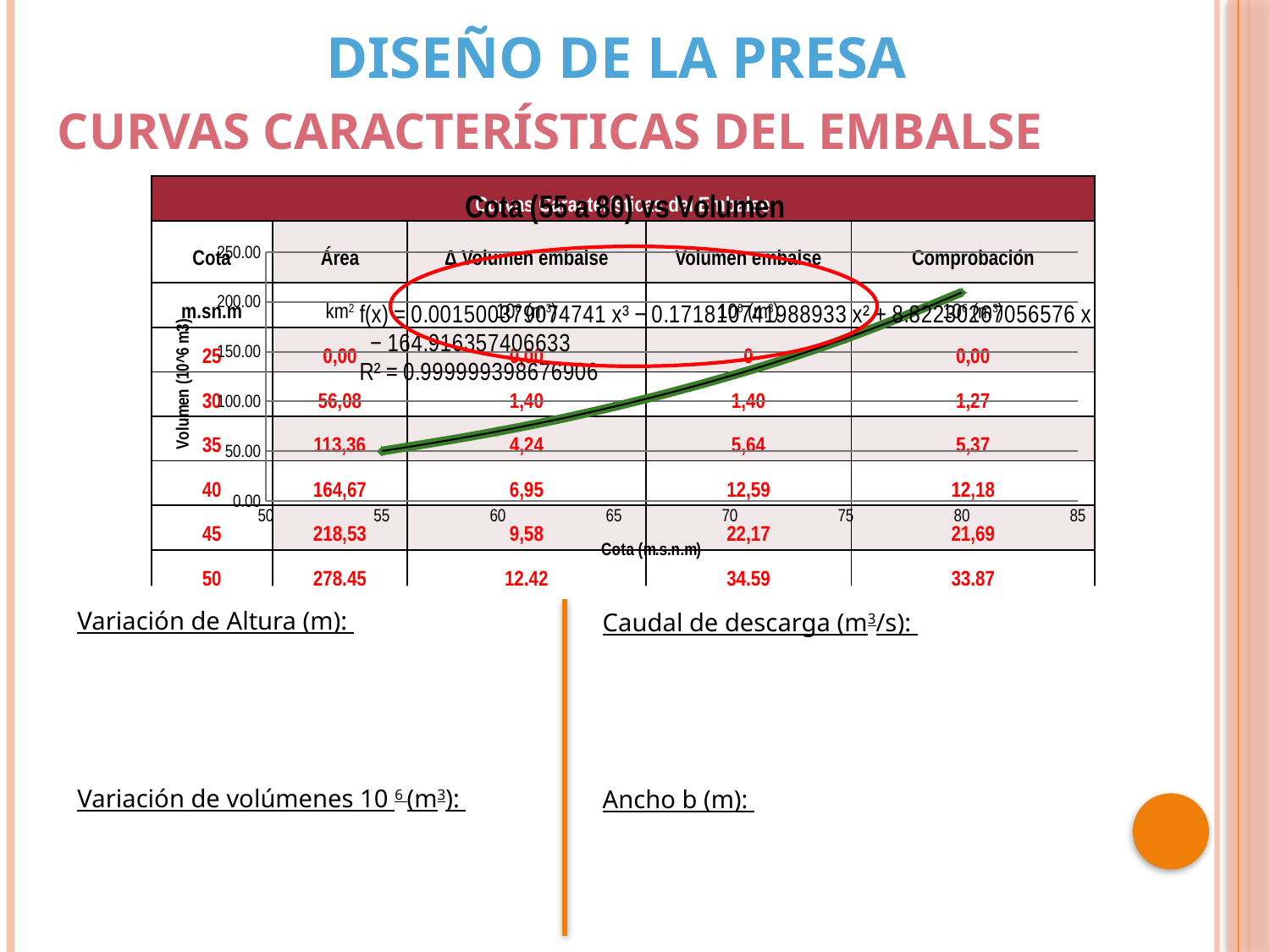
What kind of chart is shown on the slide? line chart Which end of the curve has the larger volume, the point at cota 60 or the point at cota 80? cota 80 What is the label of the x axis of the chart? Cota (m.s.n.m) What is the highest tick value shown on the y axis of the chart? 250.00 What is the highest tick value shown on the x axis of the chart? 85 What is the title of the chart on the slide? Cota (55 a 80) vs Volumen What R² value is printed on the chart for the fitted curve? 0.9999999398676906 Does the plotted volume rise or fall as the cota increases along the x axis? rises Is the plotted volume at cota 80 greater or less than 150.00? greater Is the plotted volume at cota 60 greater or less than 100.00? less